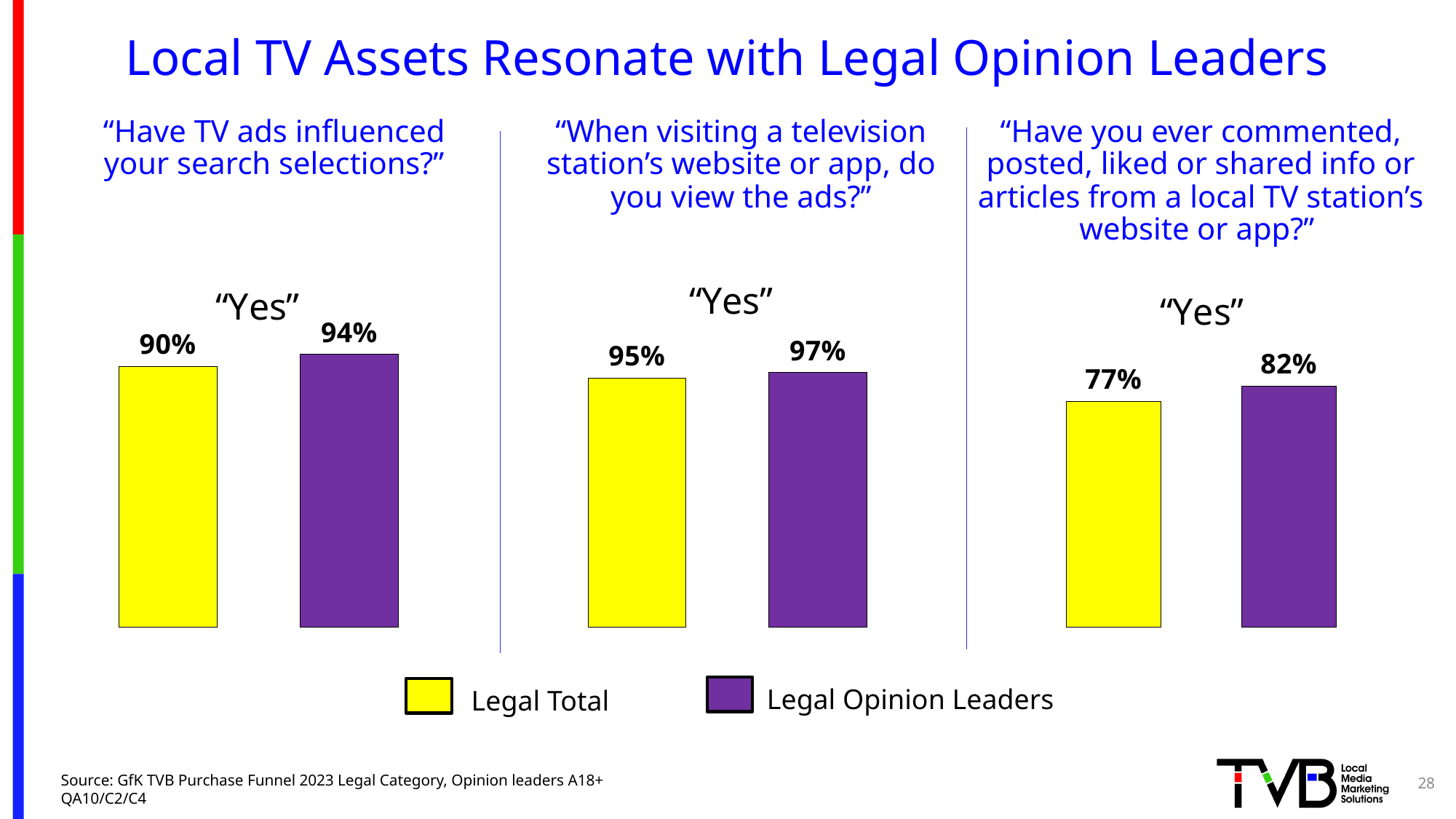
In the middle chart ("When visiting a television station's website or app, do you view the ads?"), what is the value for Legal Total? 95% In the middle chart ("When visiting a television station's website or app, do you view the ads?"), what is the difference in percentage points between Legal Opinion Leaders and Legal Total? 2 percentage points Which colour represents Legal Opinion Leaders in the legend? Purple In the right chart ("Have you ever commented, posted, liked or shared info or articles..."), what is the difference in percentage points between Legal Opinion Leaders and Legal Total? 5 percentage points How many series does the legend list? 2 In the left chart ("Have TV ads influenced your search selections?"), what percentage of Legal Opinion Leaders answered "Yes"? 94% In the right chart ("Have you ever commented, posted, liked or shared info or articles from a local TV station's website or app?"), what is the value for Legal Total? 77% In the middle chart ("When visiting a television station's website or app, do you view the ads?"), what is the value for Legal Opinion Leaders? 97% In the right chart ("Have you ever commented, posted, liked or shared info or articles from a local TV station's website or app?"), what is the value for Legal Opinion Leaders? 82% In the left chart ("Have TV ads influenced your search selections?"), what percentage of Legal Total answered "Yes"? 90% In the left chart ("Have TV ads influenced your search selections?"), which group has the higher "Yes" percentage, Legal Total or Legal Opinion Leaders? Legal Opinion Leaders What kind of chart is used in the left chart ("Have TV ads influenced your search selections?")? Bar chart